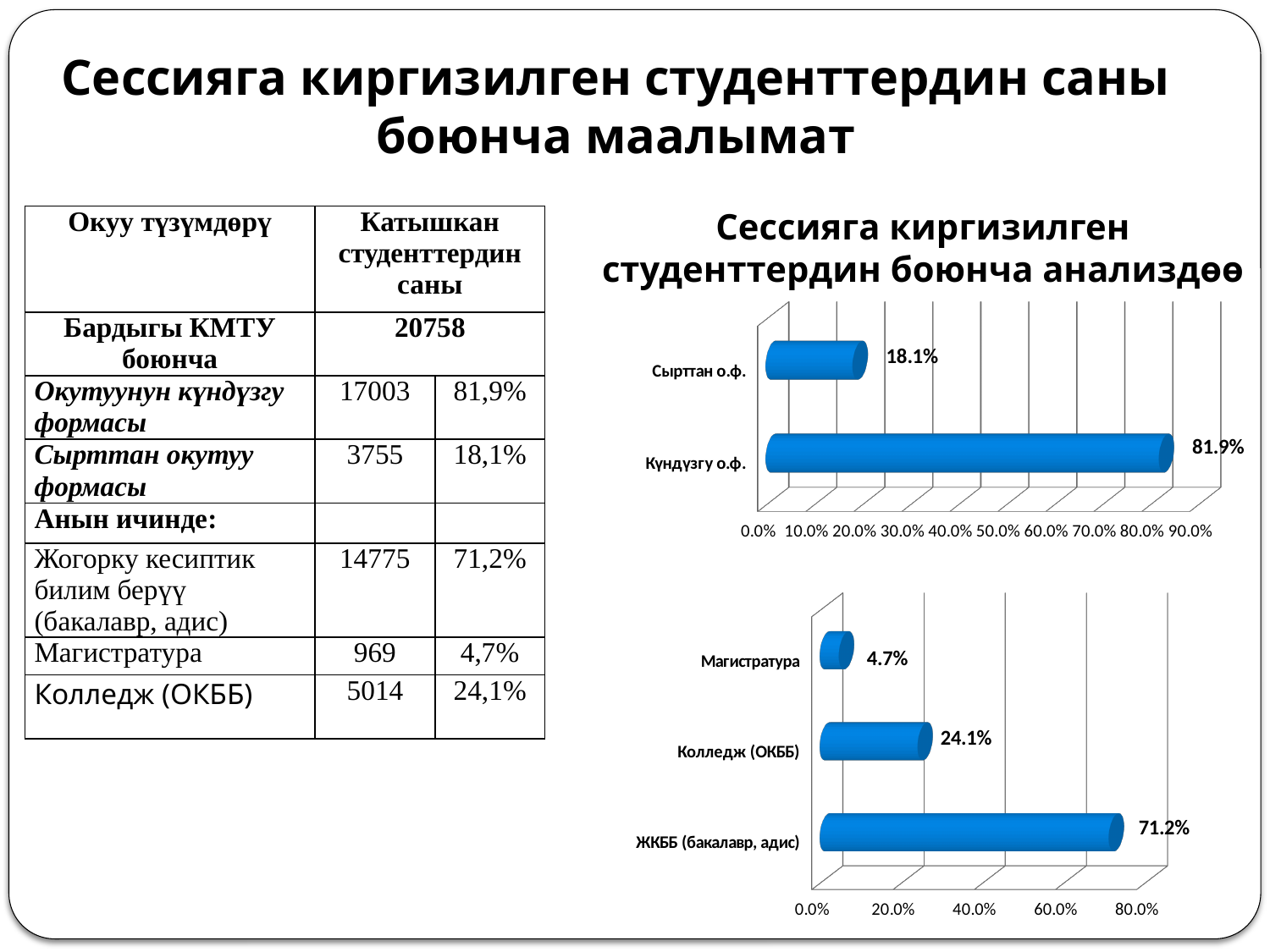
In the bottom chart, what is the difference between the values for Колледж (ОКББ) and Магистратура? 19.4% What kind of chart is the top chart on the slide? Bar chart In the top chart titled 'Сессияга киргизилген студенттердин боюнча анализдөө', what is the value for Күндүзгү о.ф.? 81.9% In the bottom chart, which category has the highest value? ЖКББ (бакалавр, адис) In the top chart titled 'Сессияга киргизилген студенттердин боюнча анализдөө', what is the value for Сырттан о.ф.? 18.1% In the bottom chart, what is the value for Колледж (ОКББ)? 24.1% How many categories are shown in the top chart? 2 How many categories are shown in the bottom chart? 3 In the bottom chart, which category has the lowest value? Магистратура In the top chart, which category has the higher value? Күндүзгү о.ф. In the bottom chart, what is the value for ЖКББ (бакалавр, адис)? 71.2% In the top chart, what is the difference between the values for Күндүзгү о.ф. and Сырттан о.ф.? 63.8%